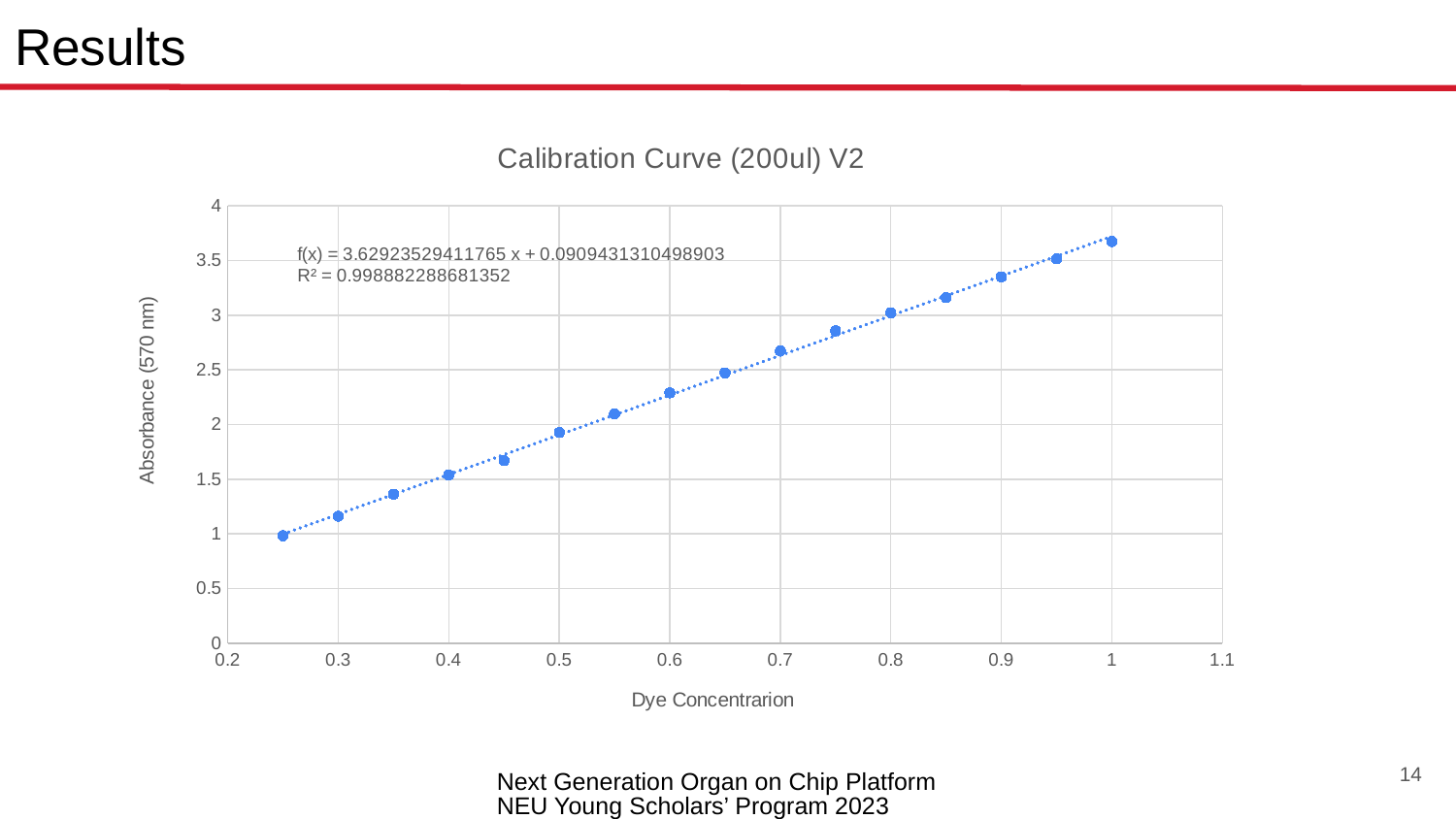
At which dye concentration is the absorbance highest? 1 What kind of chart is shown on the slide? Scatter chart Is the absorbance at dye concentration 0.9 greater or less than 3.5? less Which has the higher absorbance: dye concentration 0.8 or dye concentration 0.5? 0.8 Is the absorbance at dye concentration 0.45 greater or less than 1.5? greater Does absorbance rise or fall as dye concentration increases along the x axis? Rise At which dye concentration is the absorbance lowest? 0.25 How many data points are plotted on the chart? 16 Is the absorbance at dye concentration 1 greater or less than 3.5? greater What is the R² value printed on the chart? 0.998882288681352 What is the title of the chart? Calibration Curve (200ul) V2